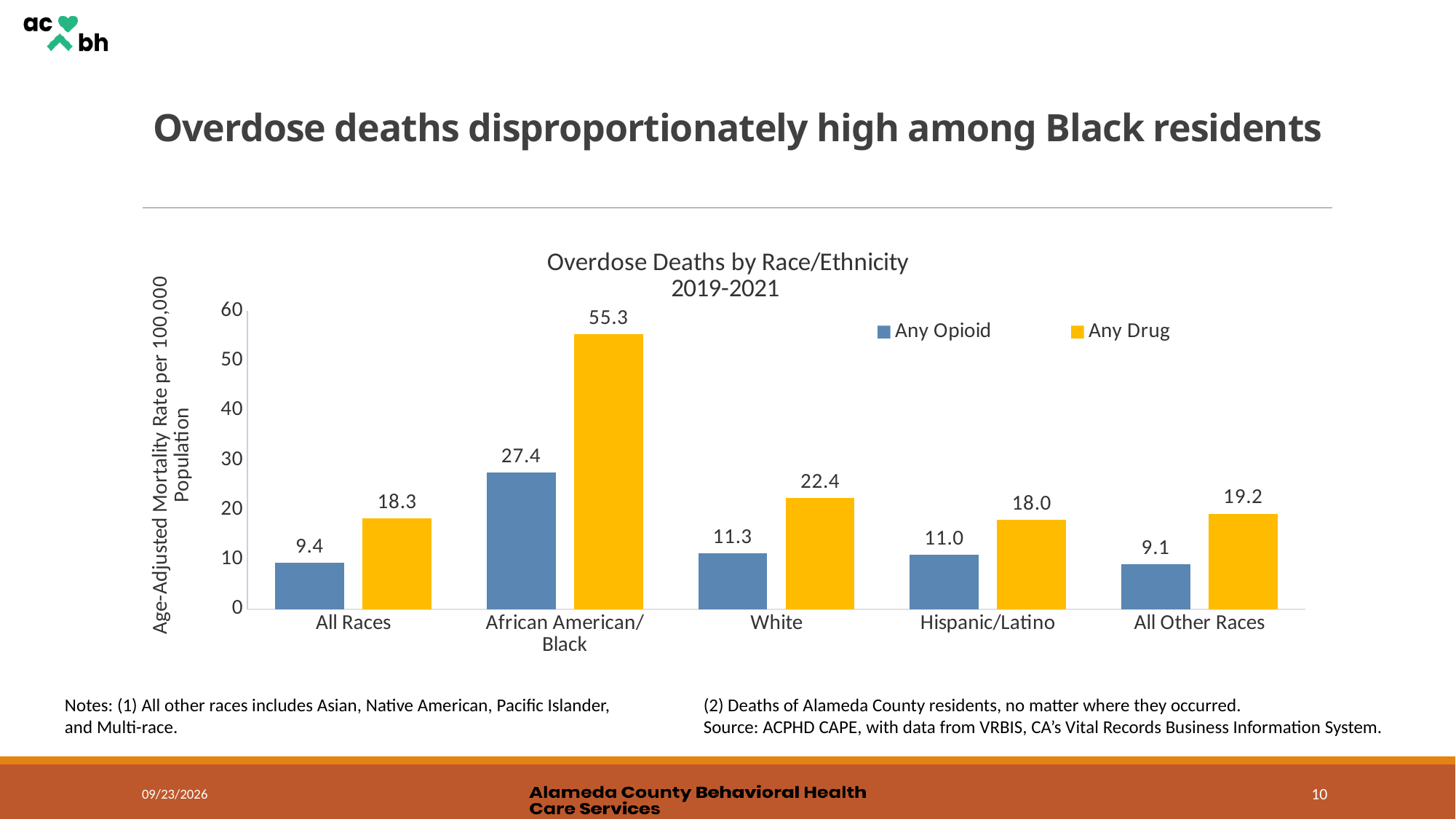
Which category has the lowest Any Opioid rate? All Other Races Is the Any Drug value for African American/Black greater or less than 50? greater Which is larger, the Any Drug rate for White residents or the Any Drug rate for All Other Races? Any Drug rate for White residents What is the difference between the Any Drug and Any Opioid rates for African American/Black residents? 27.9 What kind of chart is shown on the slide? Bar chart What is the Any Drug value for Hispanic/Latino? 18.0 What is the Any Drug overdose mortality rate for African American/Black residents? 55.3 What is the Any Opioid overdose mortality rate for White residents? 11.3 What is the title of the chart? Overdose Deaths by Race/Ethnicity 2019-2021 How many series does the legend list? 2 Which race/ethnicity category has the highest Any Opioid rate? African American/Black How many race/ethnicity categories are shown on the x axis? 5